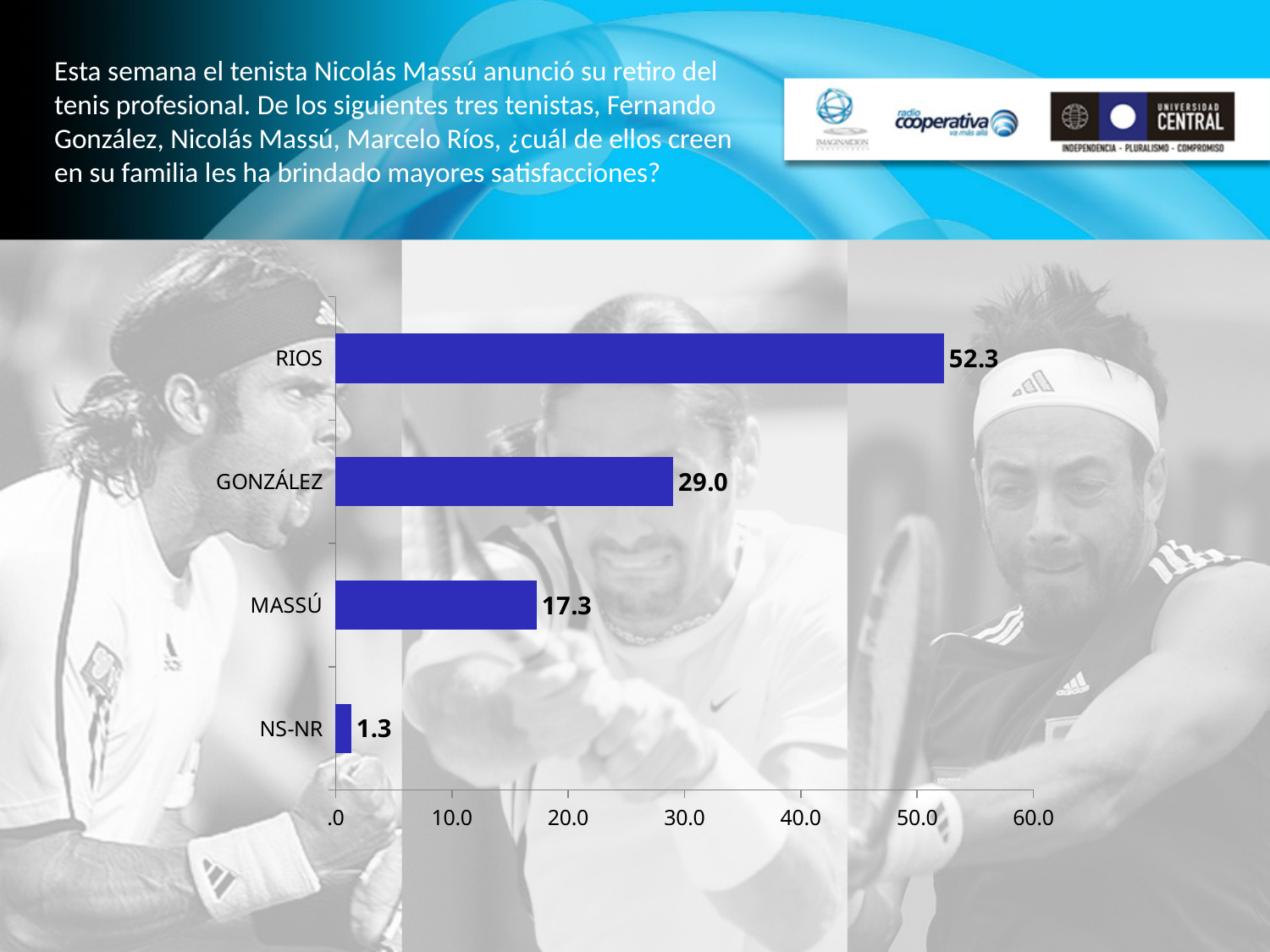
What kind of chart is shown on the slide? Bar chart What is the difference between the values for RIOS and GONZÁLEZ? 23.3 What is the value for GONZÁLEZ? 29.0 Which category has the lowest value? NS-NR Is the value for RIOS greater or less than 50.0? greater Which is larger, the value for MASSÚ or the value for GONZÁLEZ? GONZÁLEZ What is the difference between the values for GONZÁLEZ and MASSÚ? 11.7 What is the value for RIOS? 52.3 What is the value for MASSÚ? 17.3 How many categories are shown in the chart? 4 Which category has the highest value? RIOS What is the value for NS-NR? 1.3